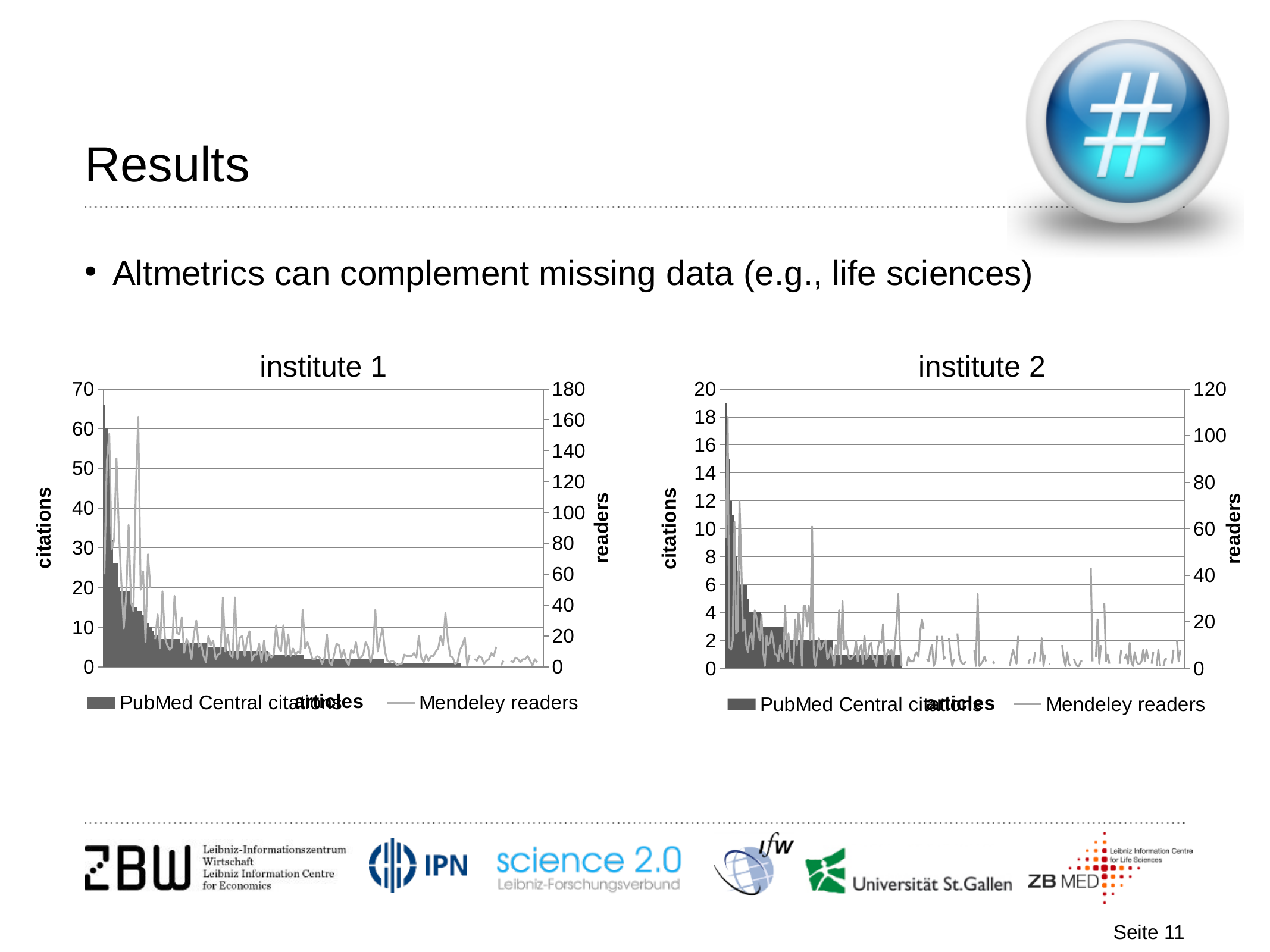
In the institute 2 chart, is the highest Mendeley readers value greater or less than 100? greater In the institute 1 chart, do the PubMed Central citations bars rise or fall along the x axis? Fall In the institute 1 chart, is the highest Mendeley readers value greater or less than 140? greater In the institute 1 chart, how many series does the legend list? 2 In the institute 2 chart, do the PubMed Central citations bars rise or fall along the x axis? Fall In the institute 2 chart, what is the maximum value shown on the right-hand readers axis? 120 In the institute 1 chart, is the highest PubMed Central citations value greater or less than 60? greater What is the title of the right chart? institute 2 In the institute 2 chart, which two series are listed in the legend? PubMed Central citations and Mendeley readers What kind of chart is the institute 1 chart? Combined bar and line chart